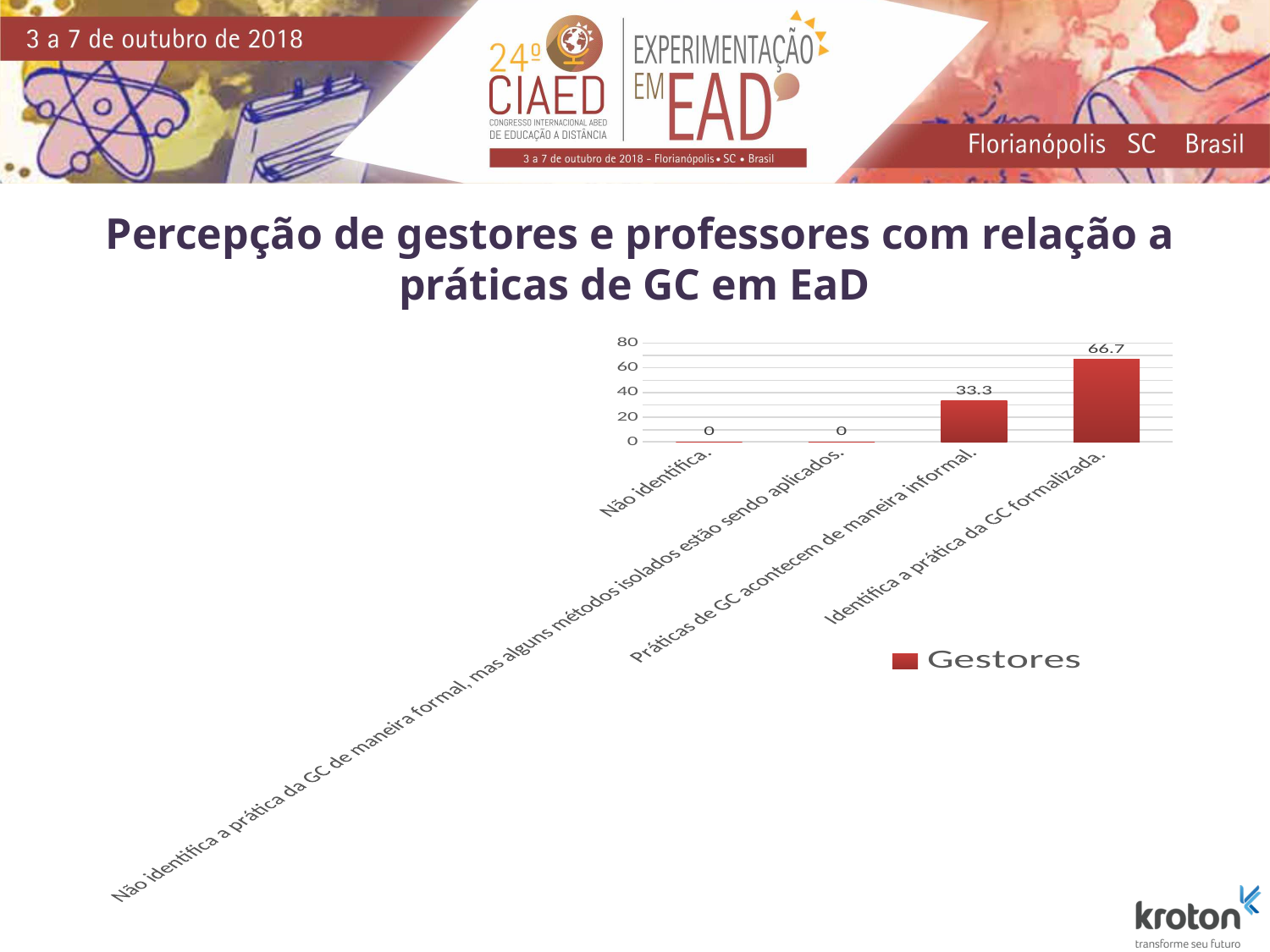
Is the value for "Práticas de GC acontecem de maneira informal." greater or less than 40? less How many series does the legend list? 1 What is the value for "Não identifica."? 0 What is the difference between the values for "Identifica a prática da GC formalizada." and "Práticas de GC acontecem de maneira informal."? 33.4 What is the value for "Práticas de GC acontecem de maneira informal."? 33.3 Which category has the highest value? Identifica a prática da GC formalizada. Which is larger: the value for "Práticas de GC acontecem de maneira informal." or the value for "Identifica a prática da GC formalizada."? Identifica a prática da GC formalizada. How many categories are shown on the x axis of the chart? 4 What is the value for "Identifica a prática da GC formalizada."? 66.7 What kind of chart is shown on the slide? bar chart Is the value for "Identifica a prática da GC formalizada." greater or less than 60? greater What is the name of the series shown in the legend? Gestores